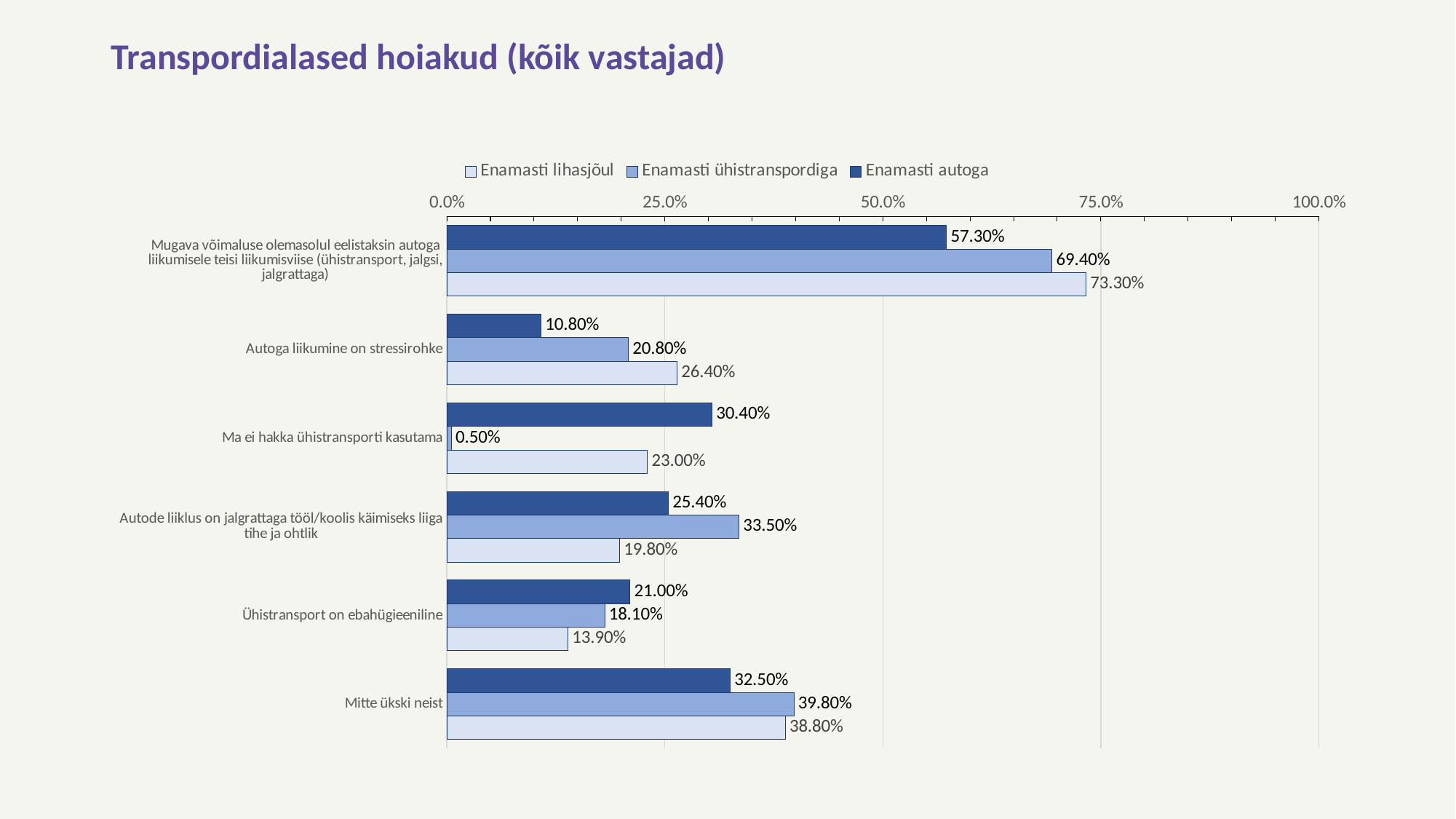
Is the value for "Enamasti ühistranspordiga" in the category "Mitte ükski neist" greater or less than 25.0%? greater What kind of chart is shown on the slide? Bar chart How many series does the legend list? 3 Which category has the highest value for the "Enamasti lihasjõul" series? Mugava võimaluse olemasolul eelistaksin autoga liikumisele teisi liikumisviise (ühistransport, jalgsi, jalgrattaga) What is the value for "Enamasti autoga" in the category "Autoga liikumine on stressirohke"? 10.80% What is the value for "Enamasti ühistranspordiga" in the category "Ma ei hakka ühistransporti kasutama"? 0.50% What is the value for "Enamasti lihasjõul" in the category "Mitte ükski neist"? 38.80% Which category has the lowest value for the "Enamasti autoga" series? Autoga liikumine on stressirohke In the category "Autode liiklus on jalgrattaga tööl/koolis käimiseks liiga tihe ja ohtlik", which series has the larger value: "Enamasti ühistranspordiga" or "Enamasti autoga"? Enamasti ühistranspordiga What is the title of the slide? Transpordialased hoiakud (kõik vastajad) What is the difference between the "Enamasti lihasjõul" and "Enamasti autoga" values in the category "Mugava võimaluse olemasolul eelistaksin autoga liikumisele teisi liikumisviise"? 16.00% How many categories are shown on the chart? 6